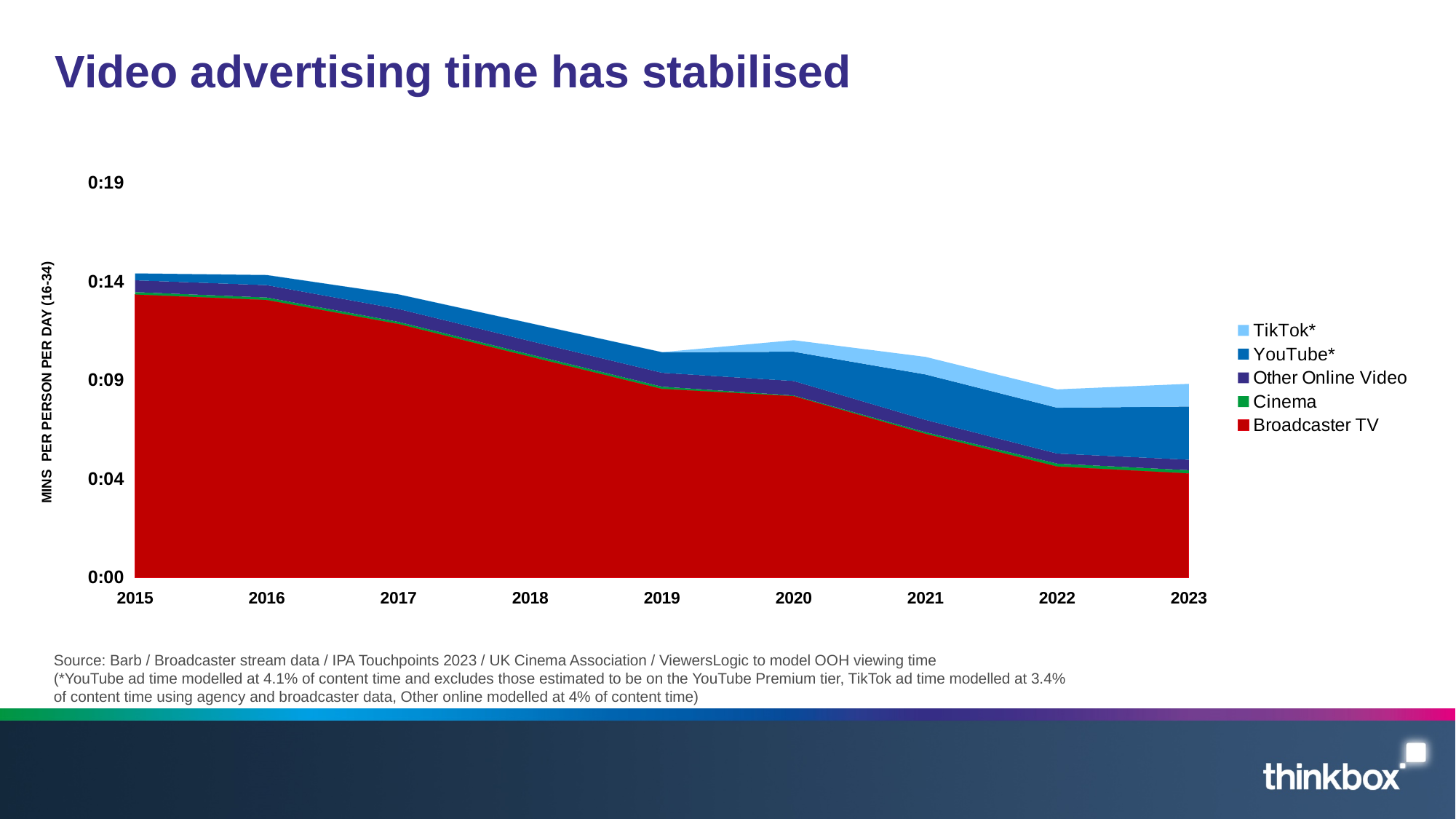
Which series accounts for the largest share of video advertising time in 2015? Broadcaster TV Which is larger: the Broadcaster TV value in 2015 or in 2023? 2015 What kind of chart is shown on the slide? Stacked area chart Is the Broadcaster TV value in 2015 greater or less than 0:09? greater What is the title of the slide? Video advertising time has stabilised How many series does the legend list? 5 Is the total video advertising time in 2015 greater or less than 0:09? greater How many years are plotted along the x axis? 9 Is the Broadcaster TV value in 2023 greater or less than 0:09? less Does the Broadcaster TV area rise or fall from 2015 to 2023? Falls Which series is listed first in the legend? TikTok*